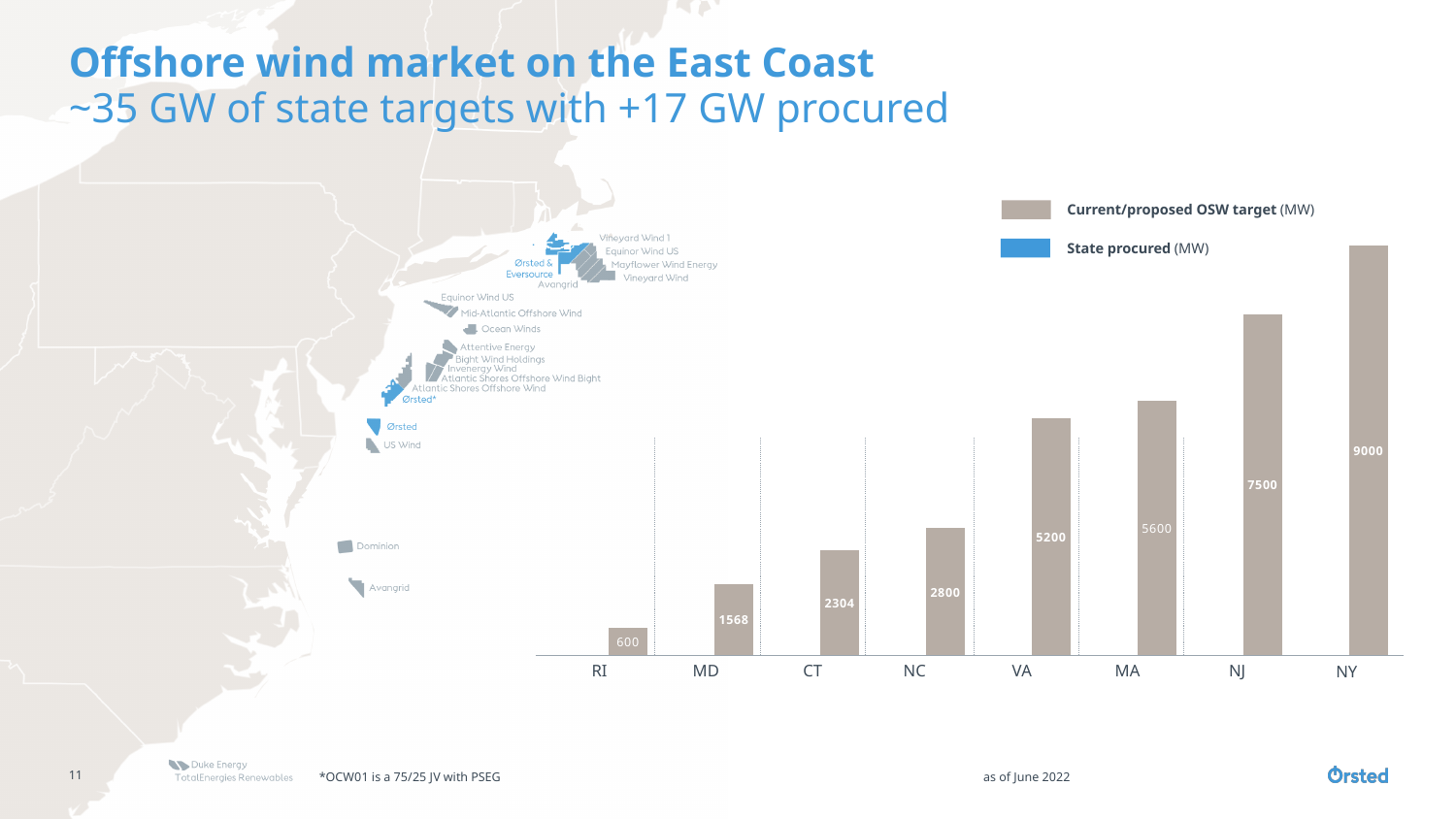
What kind of chart is shown on the slide? bar chart What is the value shown for NY in the chart? 9000 Which state has the lowest value in the chart? RI Do the values rise or fall from left to right along the x axis? rise Which has a larger value, VA or MA? MA How many states are shown on the x axis of the chart? 8 How many series does the chart legend list? 2 What is the value shown for CT in the chart? 2304 What is the difference between the values for NY and NJ? 1500 What is the value shown for MD in the chart? 1568 What is the first series named in the chart legend? Current/proposed OSW target (MW) Which state has the highest value in the chart? NY